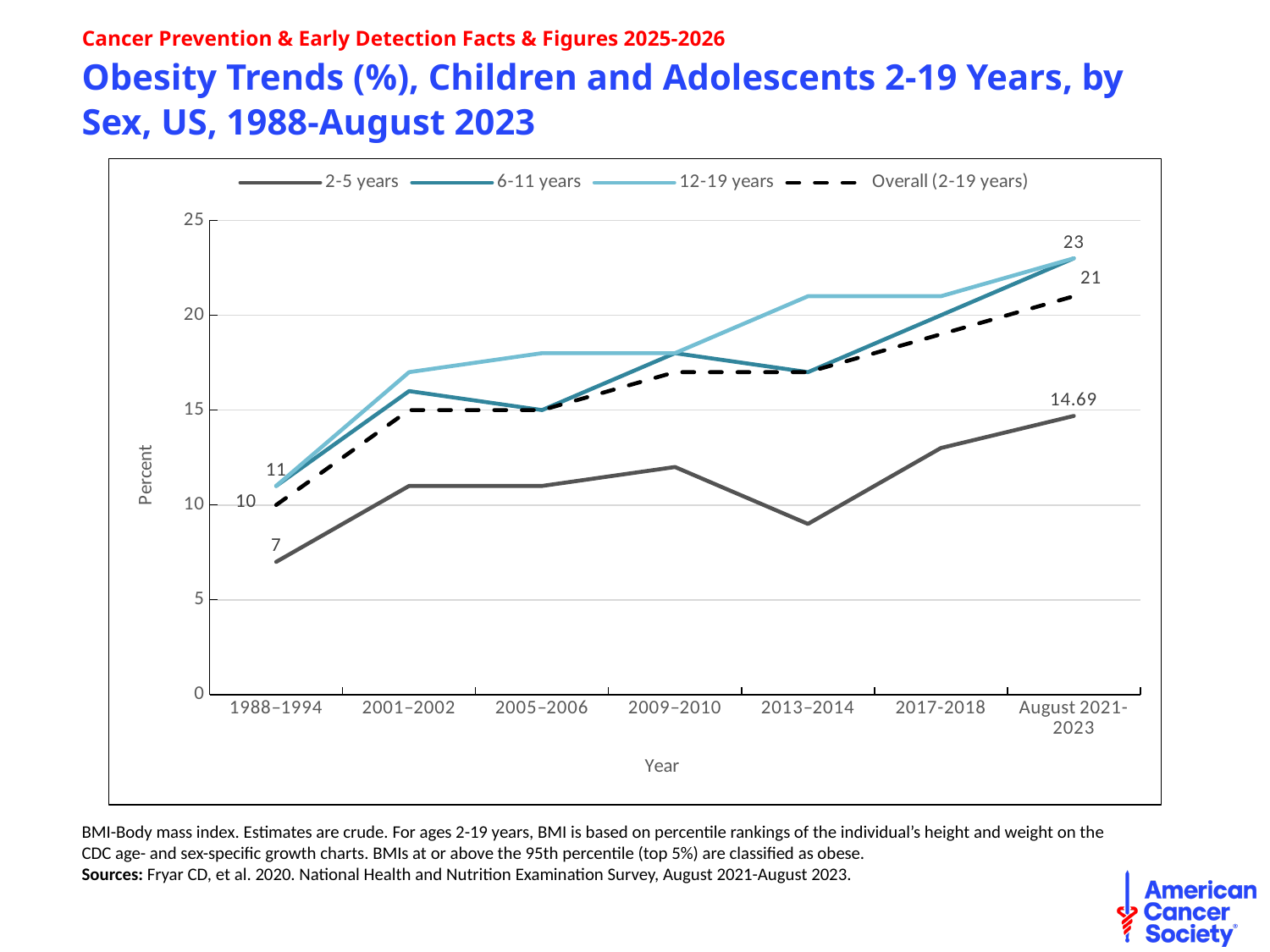
What is the value for the 2-5 years series in August 2021-2023? 14.69 Is the value for the 2-5 years series in 2013–2014 greater or less than 10? less What is the value for the 2-5 years series in 1988–1994? 7 How many time periods are shown on the x axis? 7 Is the value for the 12-19 years series in 2013–2014 greater or less than 20? greater What type of chart is shown on the slide? line chart By how much did the 2-5 years value increase from 1988–1994 to August 2021-2023? 7.69 By how much did the Overall (2-19 years) value increase from 1988–1994 to August 2021-2023? 11 What is the value for the Overall (2-19 years) series in August 2021-2023? 21 What is the value for the Overall (2-19 years) series in 1988–1994? 10 How many series does the legend list? 4 Which series has the lowest value in 1988–1994? 2-5 years